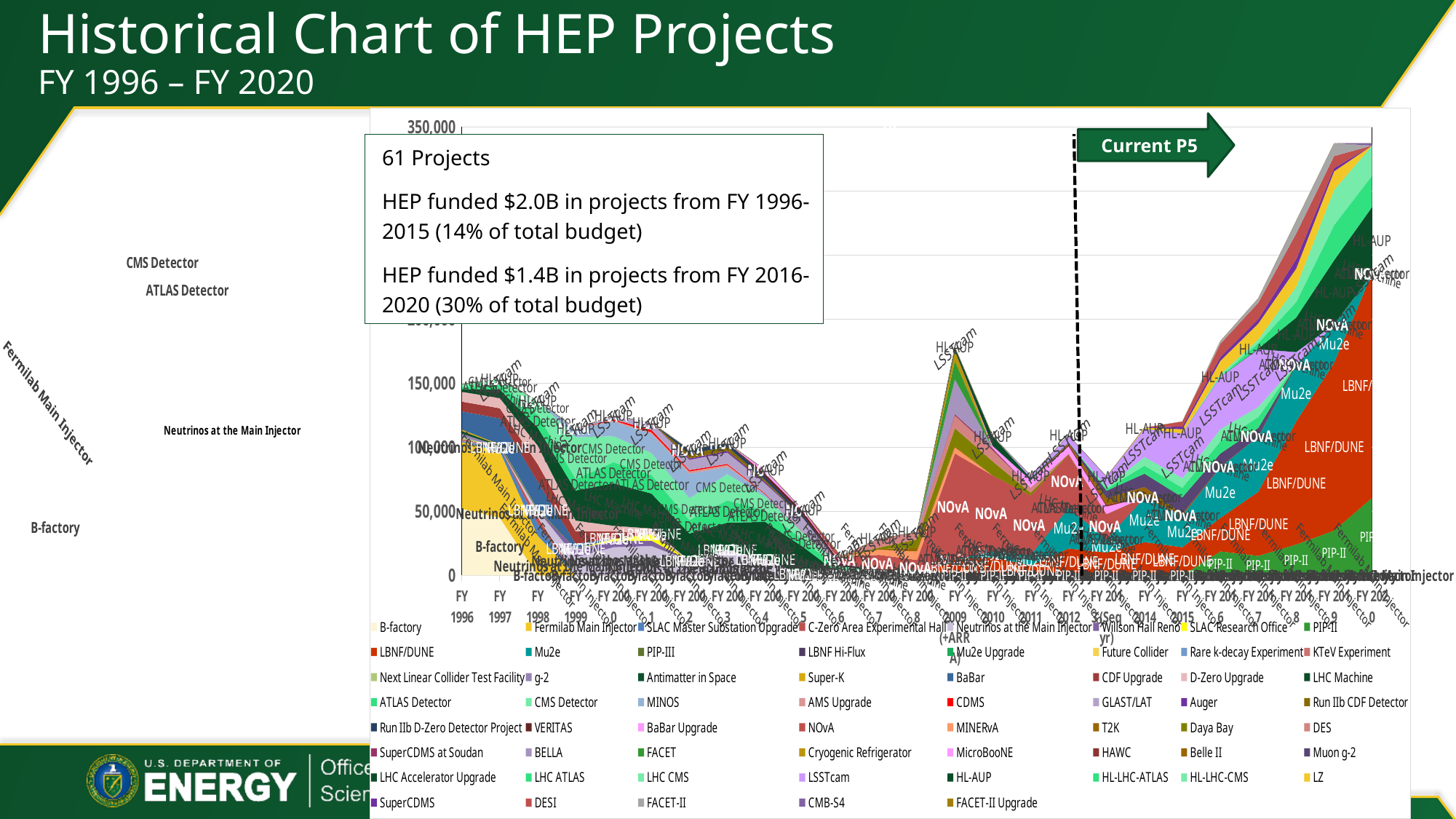
How many series does the legend list? 61 What kind of chart is shown on the slide? stacked area chart Is the total value for FY 2009 greater or less than 150,000? greater How many fiscal years are plotted along the x axis? 25 Which has the larger total, FY 1996 or FY 2020? FY 2020 What label is on the green arrow at the top right of the chart? Current P5 Is the total value for FY 2020 greater or less than 300,000? greater How many projects does the text box on the chart say are included? 61 Projects Do the total values rise or fall from FY 2015 to FY 2020? rise Is the total value for FY 2007 greater or less than 50,000? less Which has the larger total, FY 2009 or FY 2012? FY 2009